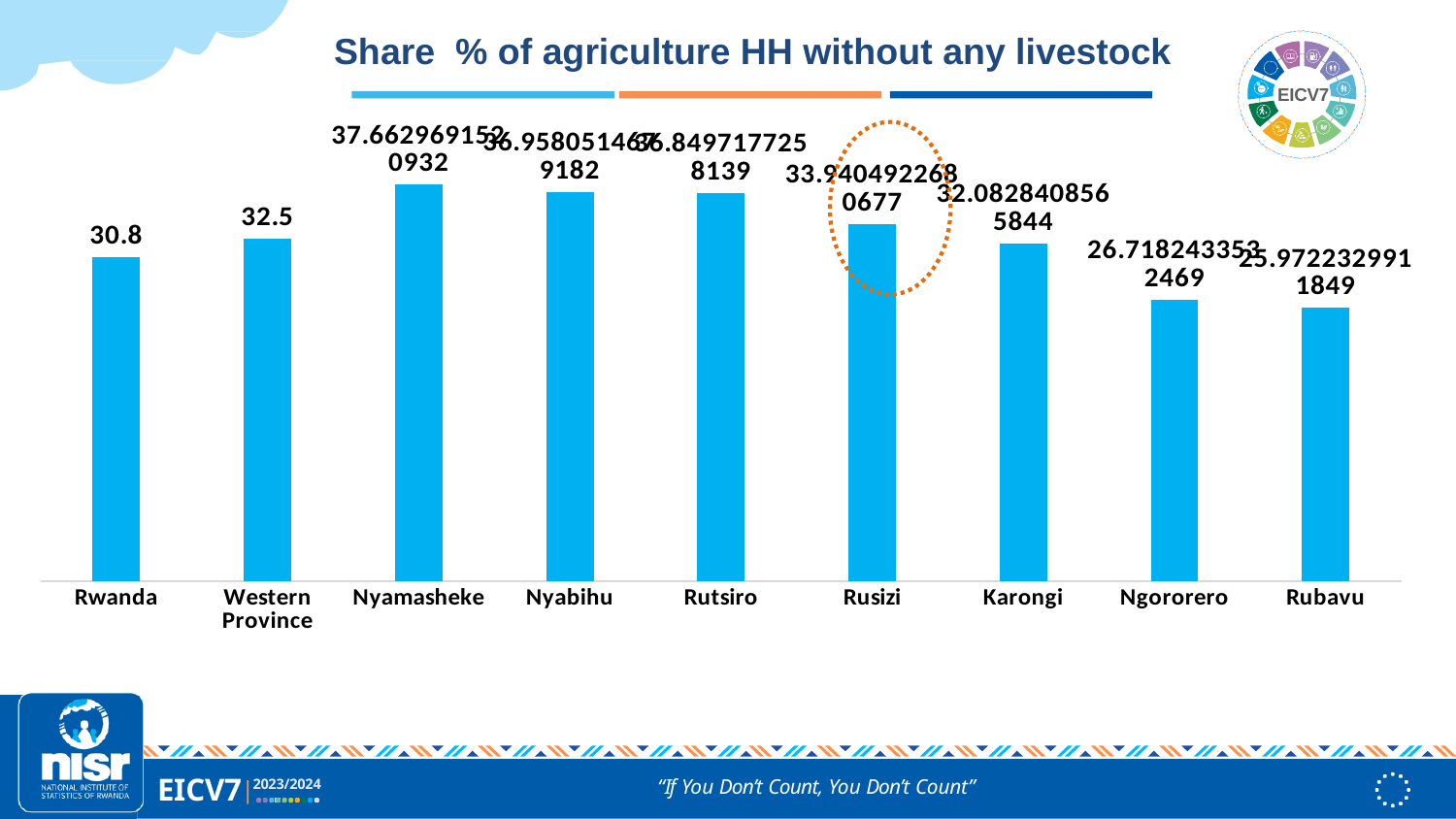
What is the value shown for Rubavu? 25.9722329911849 What is the value shown for Karongi? 32.0828408565844 Which category's bar is highlighted with a dotted orange circle? Rusizi What is the value for Western Province? 32.5 What is the difference between the values for Western Province and Rwanda? 1.7 What is the value shown for Rusizi? 33.9404922680677 What is the value for Rwanda? 30.8 Which has a larger value, Rusizi or Karongi? Rusizi Which category has the lowest value? Rubavu What kind of chart is shown on the slide? Bar chart How many categories are shown on the x axis? 9 Which category has the highest value? Nyamasheke